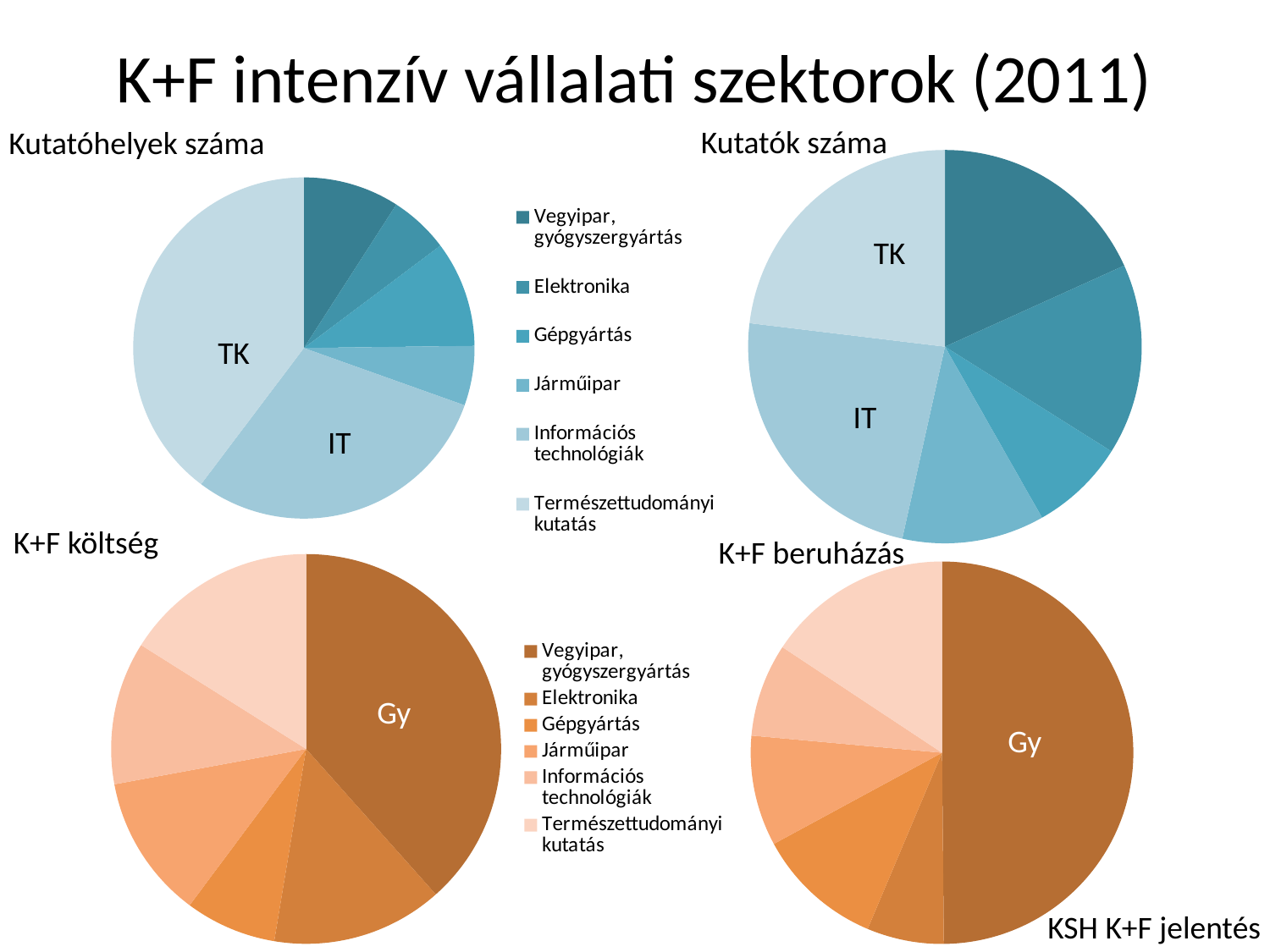
How many slices does the "K+F költség" pie chart have? 6 What kind of chart is "Kutatóhelyek száma"? Pie chart In the "Kutatóhelyek száma" chart, which category has the largest slice? Természettudományi kutatás In the "K+F beruházás" chart, which category has the largest slice? Vegyipar, gyógyszergyártás What source is cited at the bottom right of the slide? KSH K+F jelentés In the "Kutatóhelyek száma" chart, which slice is larger: Információs technológiák or Elektronika? Információs technológiák How many pie charts are shown on the slide? 4 How many entries does the legend next to the "Kutatók száma" chart list? 6 In the "K+F költség" chart, which category has the largest slice? Vegyipar, gyógyszergyártás In the "K+F beruházás" chart, which category has the smallest slice? Elektronika In the "K+F beruházás" chart, which slice is larger: Természettudományi kutatás or Elektronika? Természettudományi kutatás In the "Kutatók száma" chart, which slice is larger: Vegyipar, gyógyszergyártás or Gépgyártás? Vegyipar, gyógyszergyártás